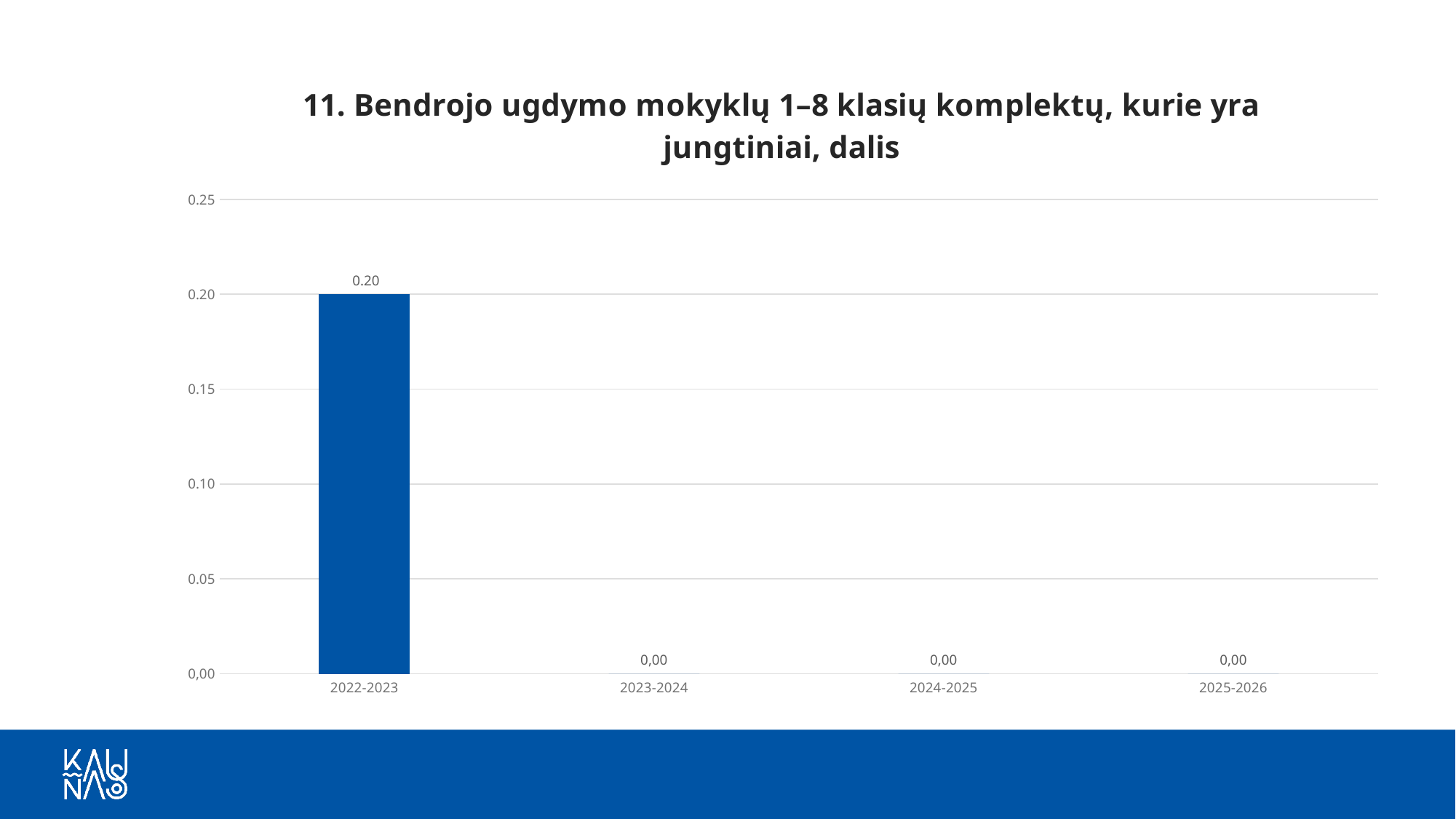
What is the value for 2022-2023? 0.20 Is the value for 2022-2023 greater or less than 0.15? greater How many categories are shown on the x axis? 4 Do the values rise or fall from 2022-2023 to 2023-2024? fall What kind of chart is shown on the slide? bar chart What is the difference between the values for 2022-2023 and 2024-2025? 0.20 What is the highest value shown on the y axis? 0.25 Which is larger, the value for 2022-2023 or the value for 2023-2024? 2022-2023 What is the value for 2023-2024? 0,00 What is the title of the chart? 11. Bendrojo ugdymo mokyklų 1–8 klasių komplektų, kurie yra jungtiniai, dalis What is the value for 2025-2026? 0,00 Which category has the highest value? 2022-2023